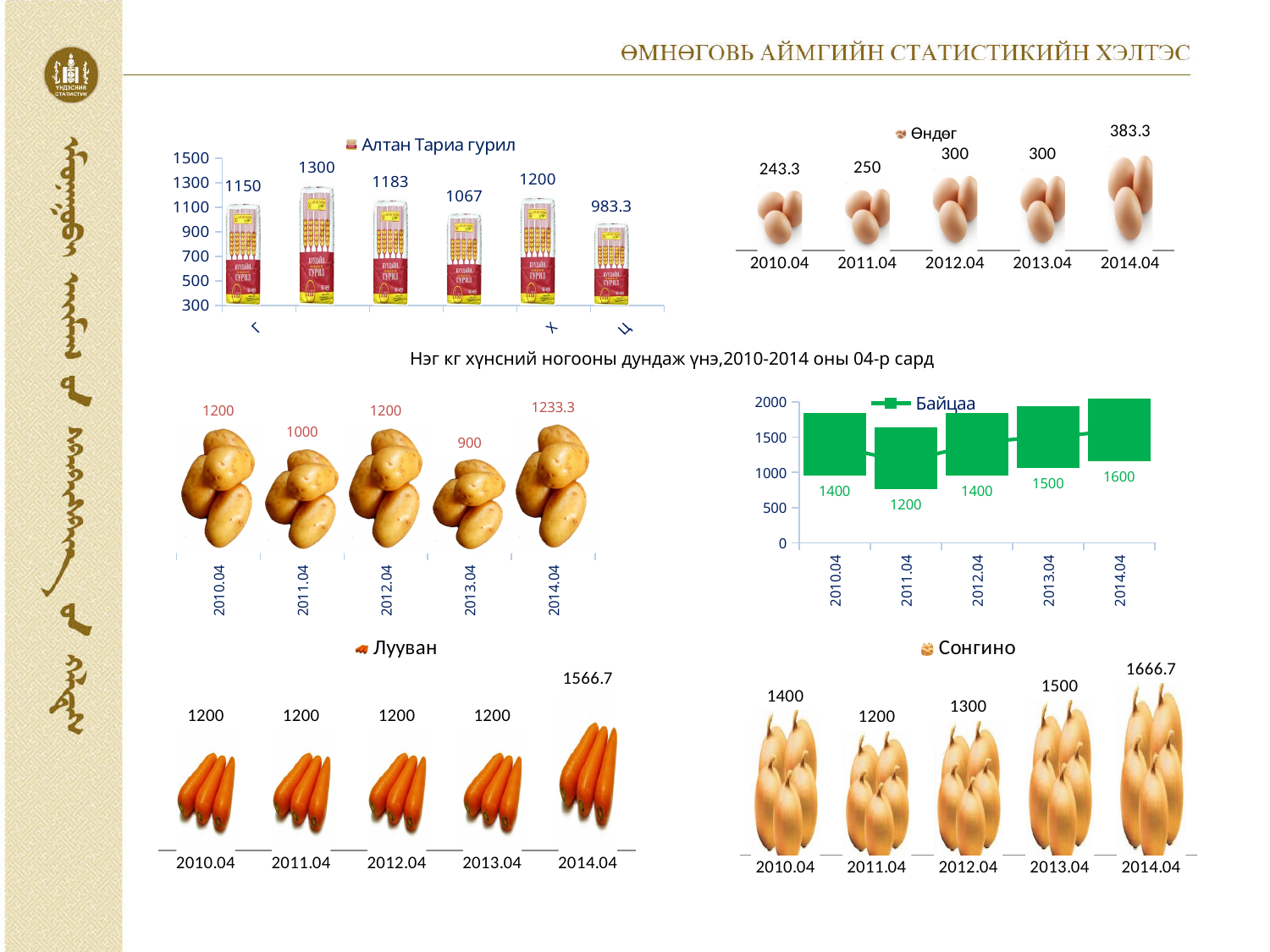
In the Сонгино chart, which year has the lowest value? 2011.04 In the Лууван chart, what is the value for 2014.04? 1566.7 In the Байцаа chart, what is the value for 2011.04? 1200 In the Өндөг chart, what is the value for 2010.04? 243.3 In the Өндөг chart, what is the difference between the values for 2014.04 and 2013.04? 83.3 In the Алтан Тариа гурил chart, how many bars are plotted? 6 In the Өндөг chart, what is the value for 2014.04? 383.3 In the Лууван chart, how many years are shown on the x axis? 5 In the potato chart (middle left), which is larger, the value for 2011.04 or 2014.04? 2014.04 In the potato chart (middle left), what is the value for 2013.04? 900 In the Сонгино chart, what is the difference between the values for 2014.04 and 2010.04? 266.7 In the Байцаа chart, which year has the highest value? 2014.04